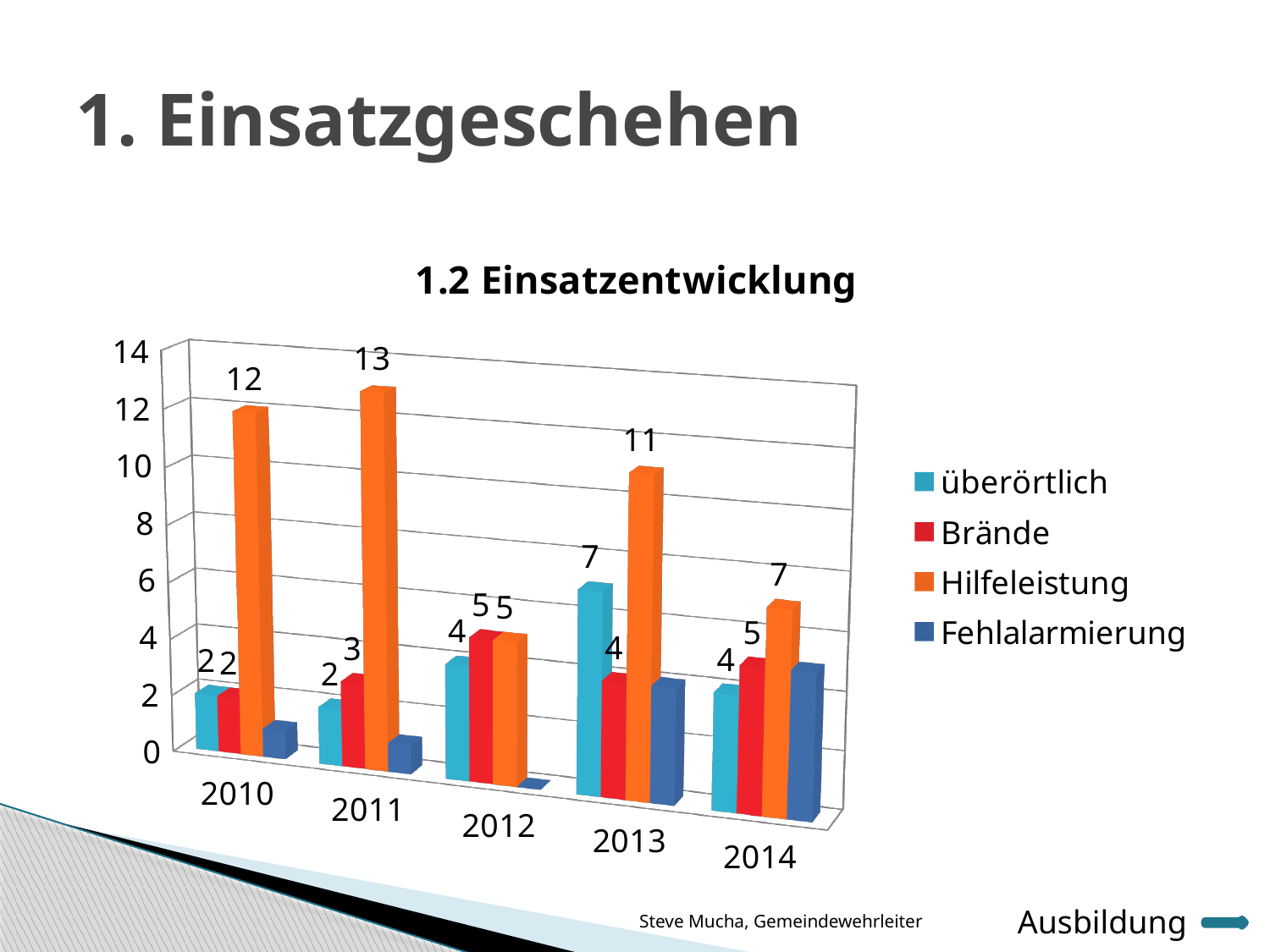
What is the value for überörtlich in 2013? 7 How many series does the legend list? 4 What is the difference between Hilfeleistung in 2011 and in 2014? 6 Is the value for Fehlalarmierung in 2012 greater or less than 2? less What is the value for Brände in 2014? 5 In which year is Hilfeleistung highest? 2011 In which year is Hilfeleistung lowest? 2012 Does Hilfeleistung rise or fall from 2011 to 2014? fall In 2013, which is larger: überörtlich or Brände? überörtlich How many years are shown on the x axis? 5 What is the value for Hilfeleistung in 2011? 13 What kind of chart is shown? bar chart